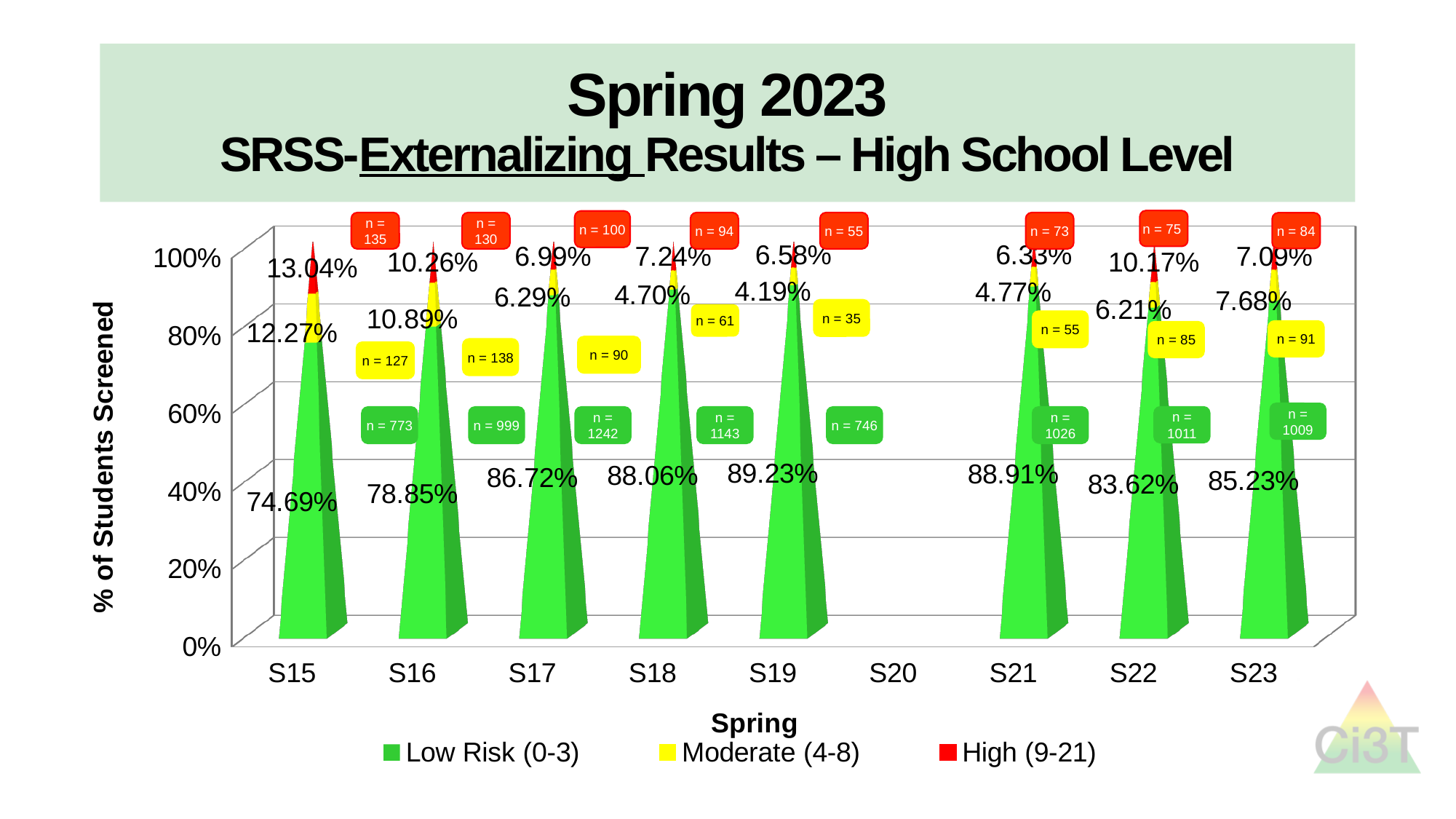
Which spring has the highest Low Risk (0-3) percentage? S19 What is the difference between the Low Risk (0-3) percentages for S19 and S15? 14.54% Which spring has the highest High (9-21) percentage? S15 What is the High (9-21) percentage for S22? 10.17% How many series does the legend list? 3 What is the Moderate (4-8) percentage for S19? 4.19% Which spring has the lowest Low Risk (0-3) percentage? S15 Which spring on the x axis has no data plotted? S20 What is the Low Risk (0-3) percentage for S15? 74.69% What is the label of the y axis? % of Students Screened Is the Moderate (4-8) percentage larger for S16 or for S23? S16 What kind of chart is shown on the slide? Stacked bar chart